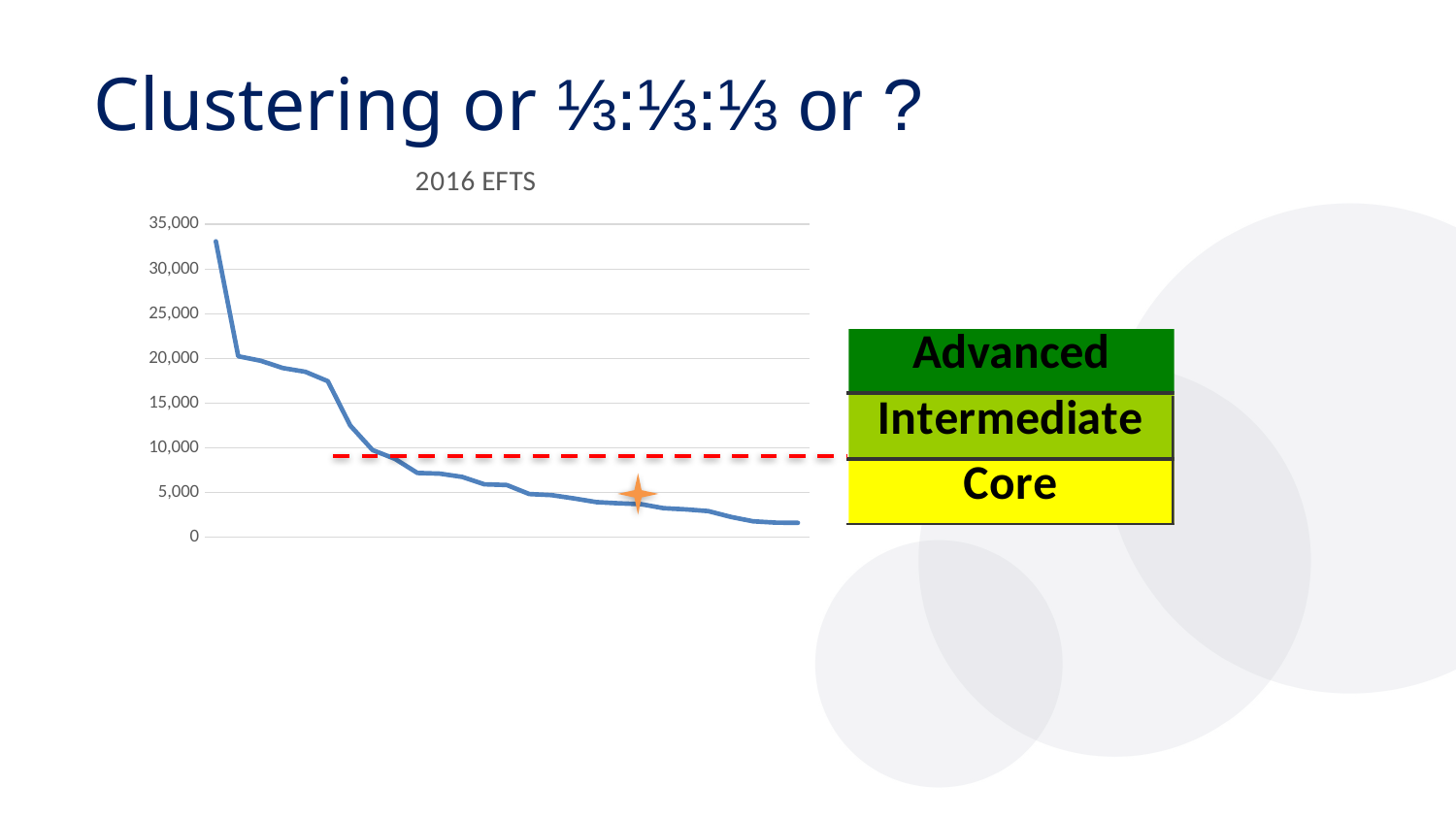
How many lines (data series) are plotted on the chart? 1 Is the value of the second point on the line greater or less than 15,000? greater What is the title of the chart? 2016 EFTS What is the highest value shown on the chart's vertical axis? 35,000 Is the value of the last (rightmost) point on the line greater or less than 5,000? less Do the values on the chart rise or fall from left to right along the x axis? fall Is the value of the point marked with the orange star greater or less than 10,000? less What kind of chart is shown on the slide? line chart